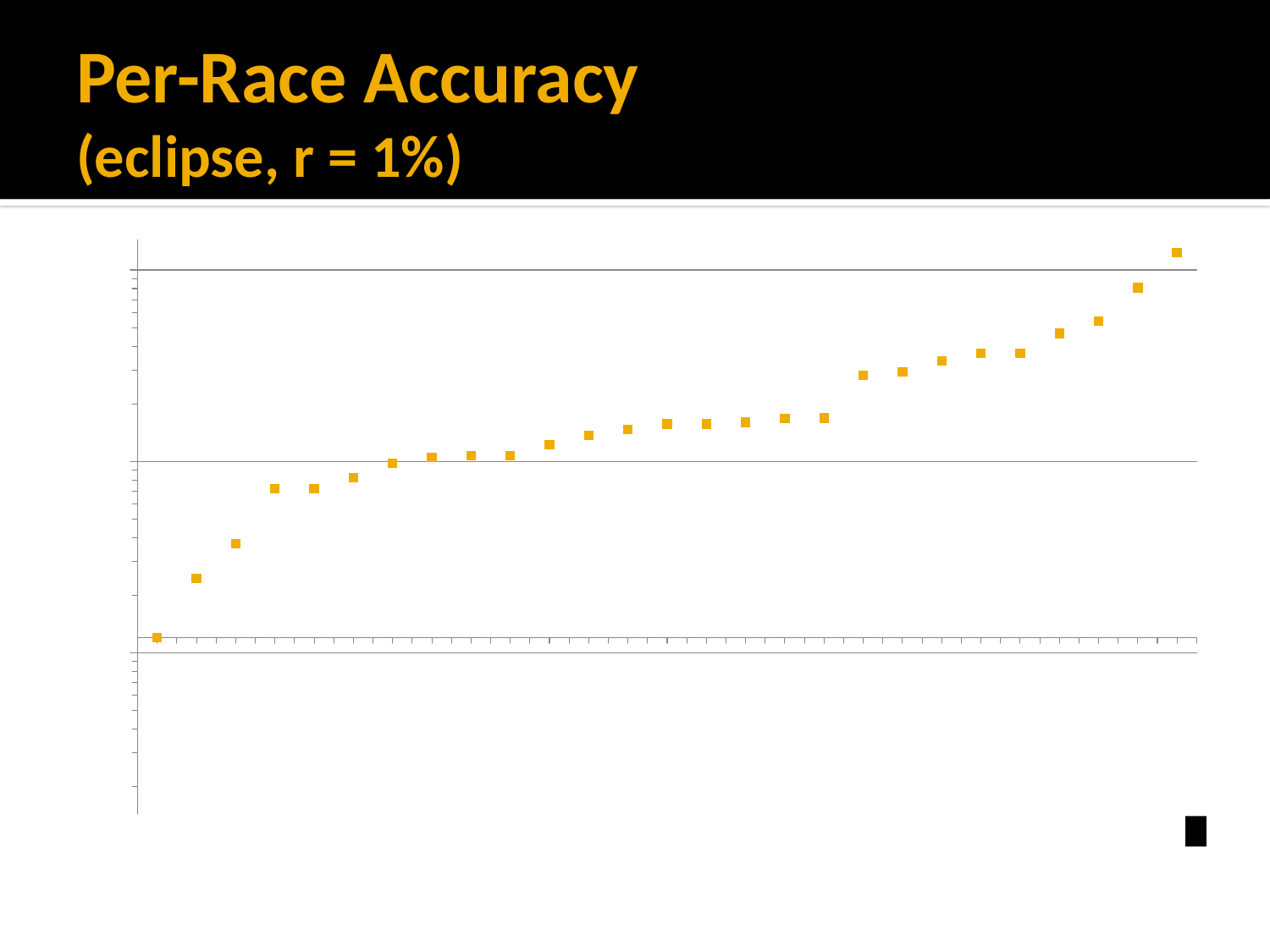
What is the title of the slide containing the chart? Per-Race Accuracy (eclipse, r = 1%) How many data points are plotted on the chart? 27 Do the plotted values rise or fall from left to right along the x axis? rise What kind of chart is shown on the slide? scatter chart What colour are the plotted markers on the chart? orange